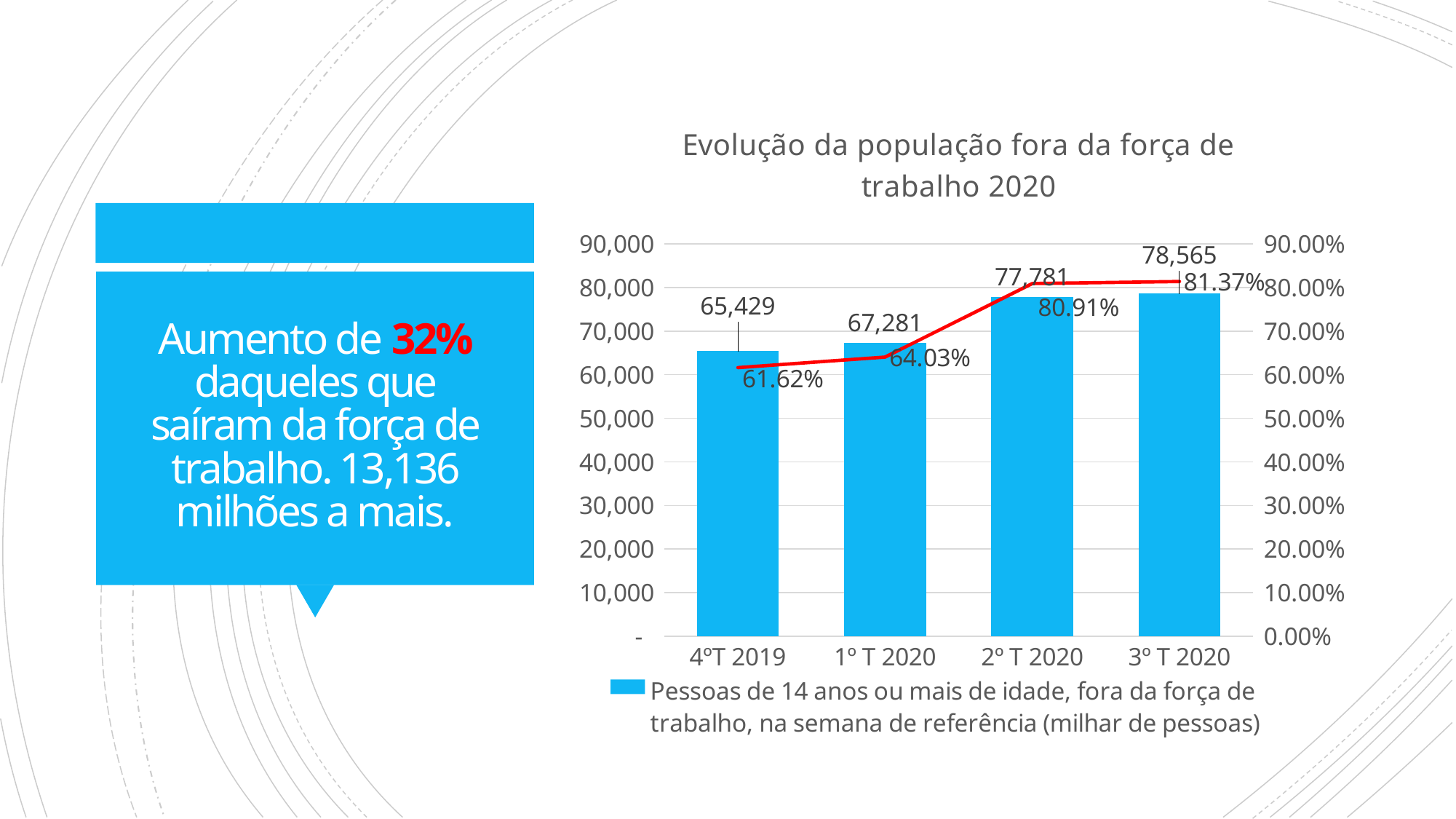
How many series does the legend list? 1 What percentage does the red line show for 1º T 2020? 64.03% How many quarters are shown on the x axis? 4 Which is larger, the bar value for 1º T 2020 or for 2º T 2020? 2º T 2020 What percentage does the red line show for 3º T 2020? 81.37% What is the value of the bar for 4ºT 2019? 65,429 What is the difference between the bar values for 3º T 2020 and 4ºT 2019? 13,136 What is the title of the chart? Evolução da população fora da força de trabalho 2020 What is the value of the bar for 2º T 2020? 77,781 Which quarter has the lowest bar value? 4ºT 2019 Do the bar values rise or fall from 4ºT 2019 to 3º T 2020? rise Which quarter has the highest bar value? 3º T 2020